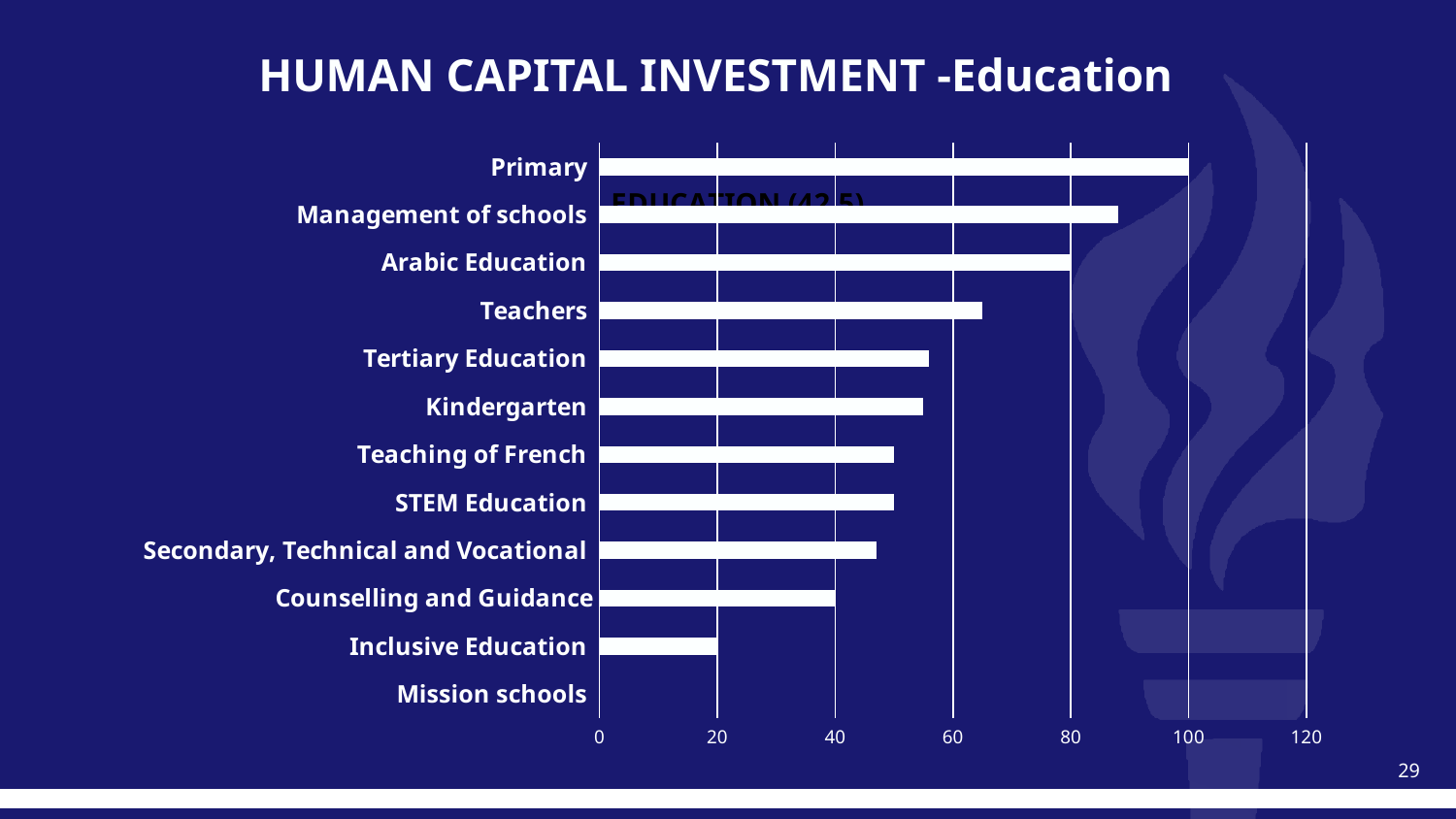
Which category has the lowest value in the chart? Mission schools Is the value for Secondary, Technical and Vocational greater or less than 40? greater What is the value for Primary? 100 How many categories are plotted in the chart? 12 What is the value for Inclusive Education? 20 Which has a larger value, Teachers or Kindergarten? Teachers Is the value for Tertiary Education greater or less than 60? less Is the value for Management of schools greater or less than 80? greater Which has a larger value, Inclusive Education or Counselling and Guidance? Counselling and Guidance What kind of chart is shown on the slide? bar chart Which category has the highest value in the chart? Primary